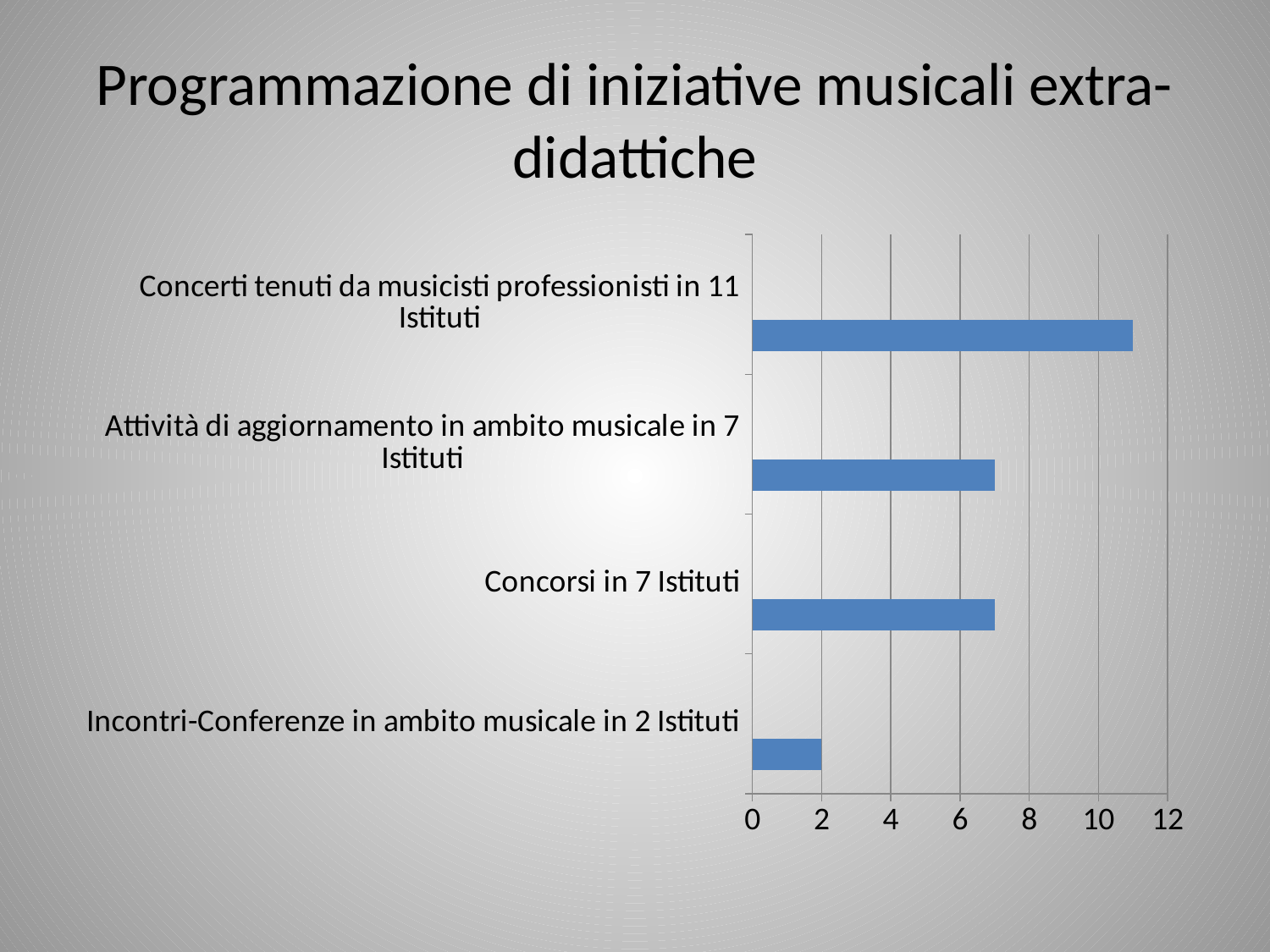
What is the difference between the number of Istituti with Concerti tenuti da musicisti professionisti and the number with Incontri-Conferenze in ambito musicale? 9 Which category has the lowest value? Incontri-Conferenze in ambito musicale in 2 Istituti In how many Istituti were Concorsi held? 7 How many categories does the chart show? 4 Which is larger: the value for Concorsi or the value for Incontri-Conferenze in ambito musicale? Concorsi In how many Istituti were concerts held by professional musicians (Concerti tenuti da musicisti professionisti)? 11 What kind of chart is shown on the slide? bar chart In how many Istituti were Incontri-Conferenze in ambito musicale held? 2 Is the value for Concerti tenuti da musicisti professionisti greater or less than 10? greater Which category has the highest value? Concerti tenuti da musicisti professionisti in 11 Istituti What is the title of the slide containing the chart? Programmazione di iniziative musicali extra-didattiche What is the difference between the number of Istituti with Concerti tenuti da musicisti professionisti and the number with Attività di aggiornamento in ambito musicale? 4